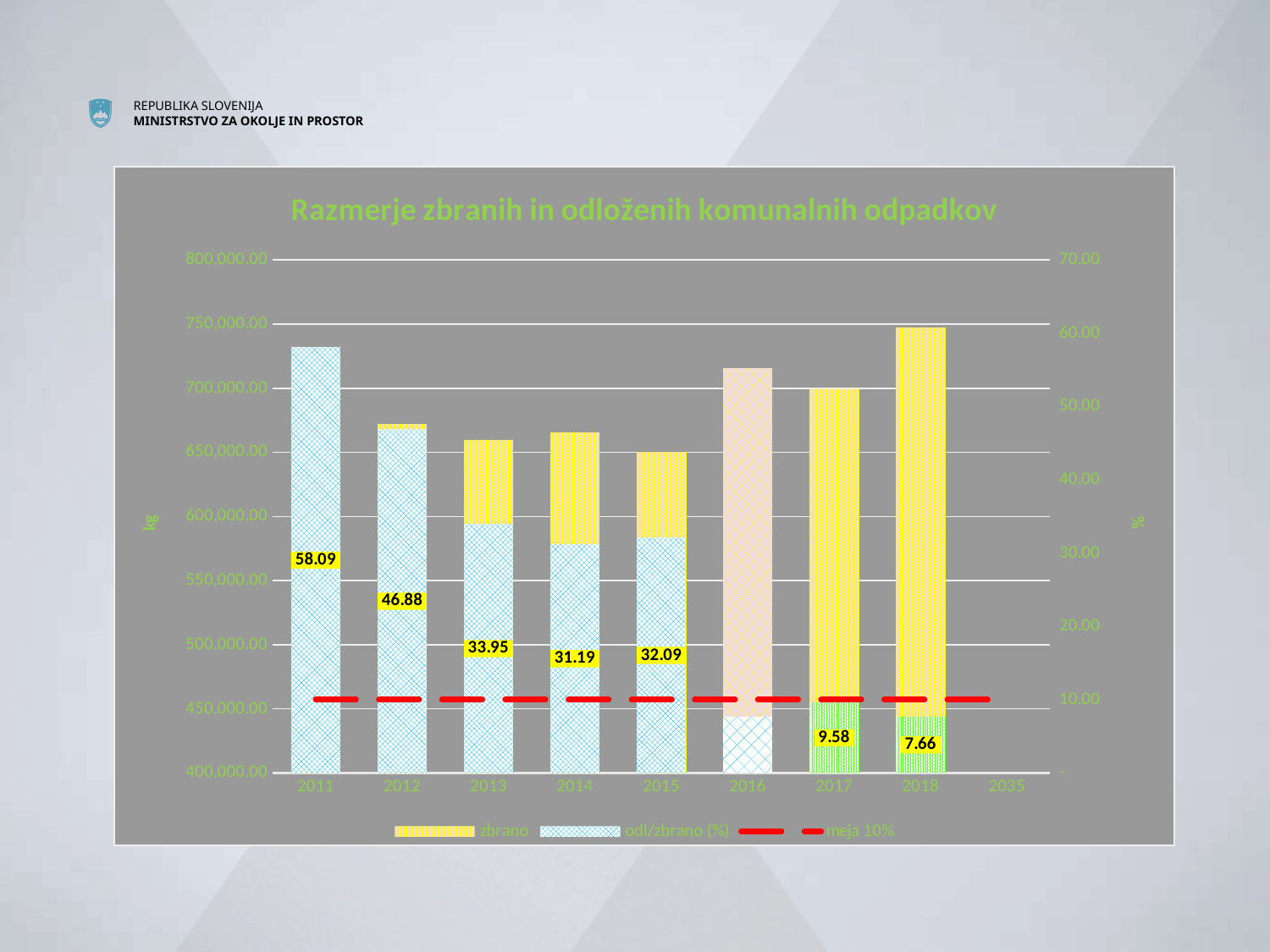
What is the difference between the odl/zbrano (%) values for 2017 and 2018? 1.92 Which year has the larger odl/zbrano (%) value, 2014 or 2015? 2015 Do the labeled odl/zbrano (%) values rise or fall from 2011 to 2018? fall Is the zbrano value for 2018 greater or less than 700,000.00 kg? greater What is the odl/zbrano (%) value for 2017? 9.58 Is the zbrano value for 2015 greater or less than 700,000.00 kg? less What is the difference between the odl/zbrano (%) values for 2011 and 2012? 11.21 What is the odl/zbrano (%) value for 2011? 58.09 Which year has the highest labeled odl/zbrano (%) value? 2011 Which year has the lowest labeled odl/zbrano (%) value? 2018 How many series does the legend list? 3 What is the odl/zbrano (%) value for 2018? 7.66